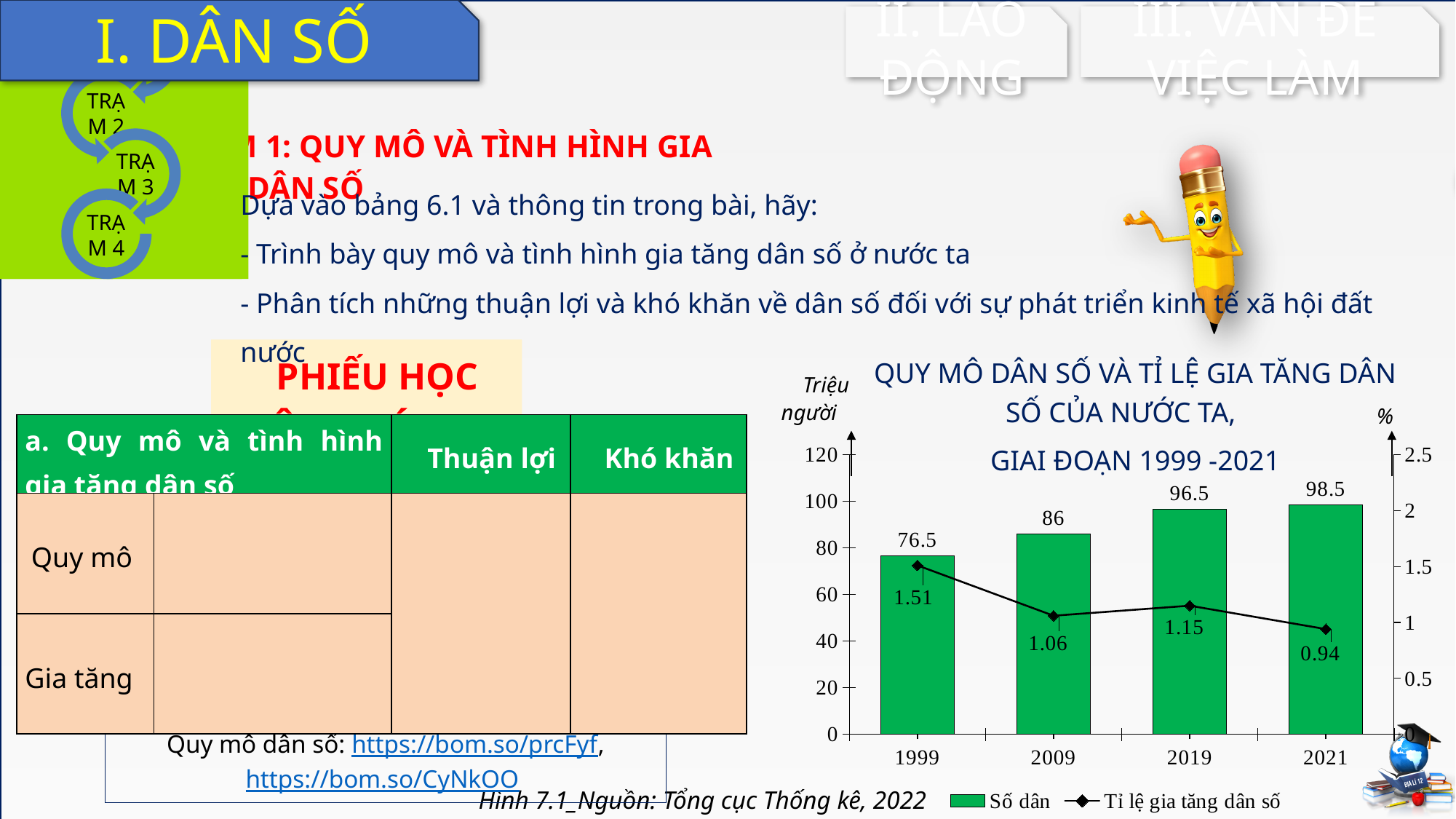
What is the population (Số dân) shown for 2019? 96.5 What is the difference in population (Số dân) between 2021 and 1999? 22 What is the difference in growth rate (Tỉ lệ gia tăng dân số) between 1999 and 2009? 0.45 What colour are the bars for Số dân in the chart? green Which year has the higher growth rate (Tỉ lệ gia tăng dân số), 2009 or 2019? 2019 In which year is the population growth rate (Tỉ lệ gia tăng dân số) lowest? 2021 What is the population growth rate (Tỉ lệ gia tăng dân số) shown for 2021? 0.94 How many series does the chart legend list? 2 Does the population (Số dân) rise or fall from 1999 to 2021? rise What is the population (Số dân) shown for 1999? 76.5 How many years are shown on the x axis of the chart? 4 In which year is the population (Số dân) highest? 2021